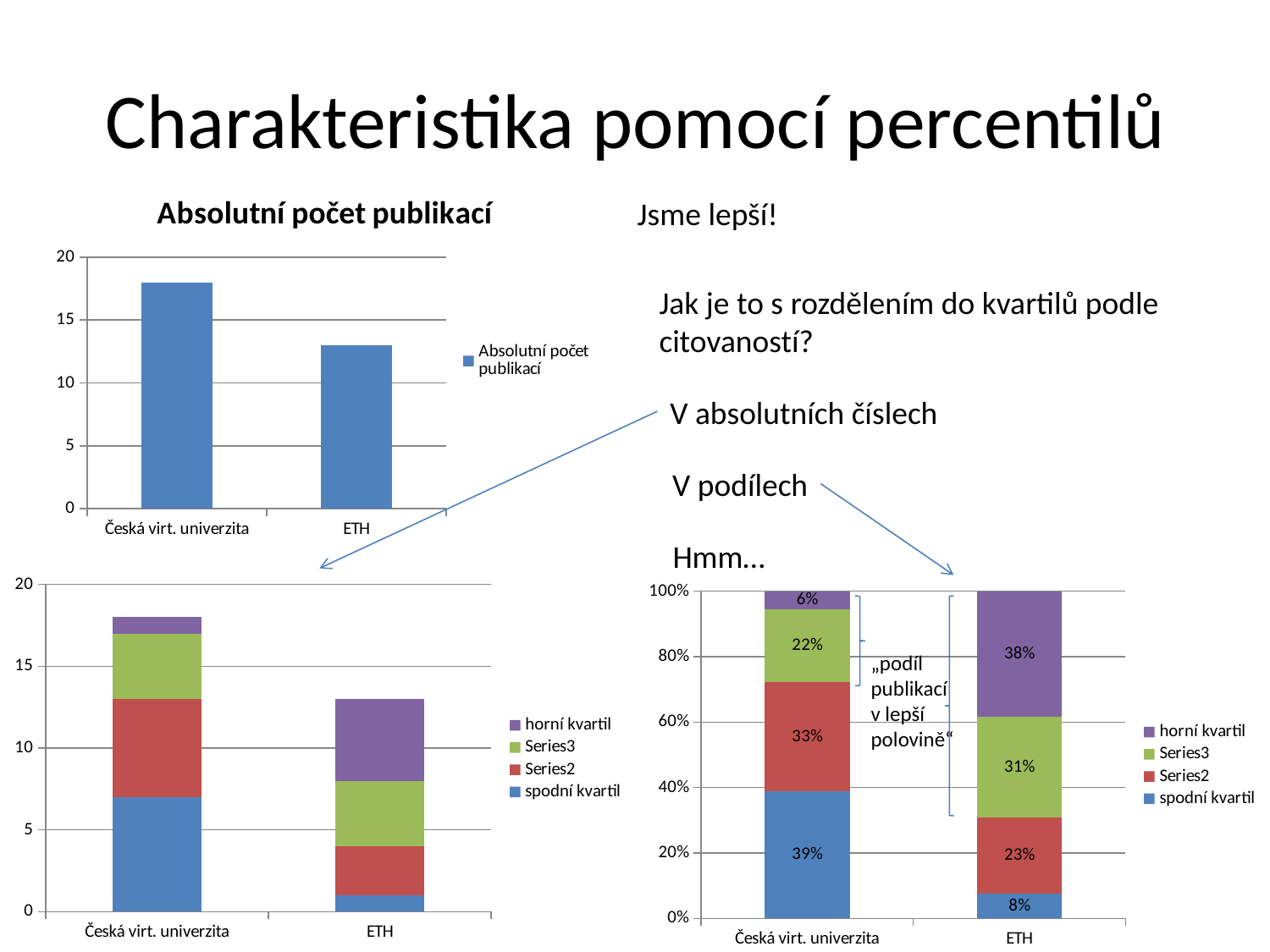
In the bottom-right 100% stacked bar chart, what is the share of 'spodní kvartil' for Česká virt. univerzita? 39% In the bottom-left stacked bar chart, is the total height of the ETH bar greater or less than 15? less In the bottom-right 100% stacked bar chart, what is the share of 'horní kvartil' for ETH? 38% In the top-left chart titled 'Absolutní počet publikací', what kind of chart is it? bar chart In the bottom-left stacked bar chart, how many series does the legend list? 4 In the top-left chart titled 'Absolutní počet publikací', which category has the higher value? Česká virt. univerzita In the bottom-right 100% stacked bar chart, how many categories are shown on the x axis? 2 In the bottom-right 100% stacked bar chart, what is the share of Series3 for ETH? 31% In the bottom-right 100% stacked bar chart, what is the difference between the 'horní kvartil' share for ETH and for Česká virt. univerzita? 32% In the bottom-right 100% stacked bar chart, which has the larger Series2 share, Česká virt. univerzita or ETH? Česká virt. univerzita In the top-left chart titled 'Absolutní počet publikací', is the value for ETH greater or less than 15? less In the top-left chart titled 'Absolutní počet publikací', is the value for Česká virt. univerzita greater or less than 15? greater